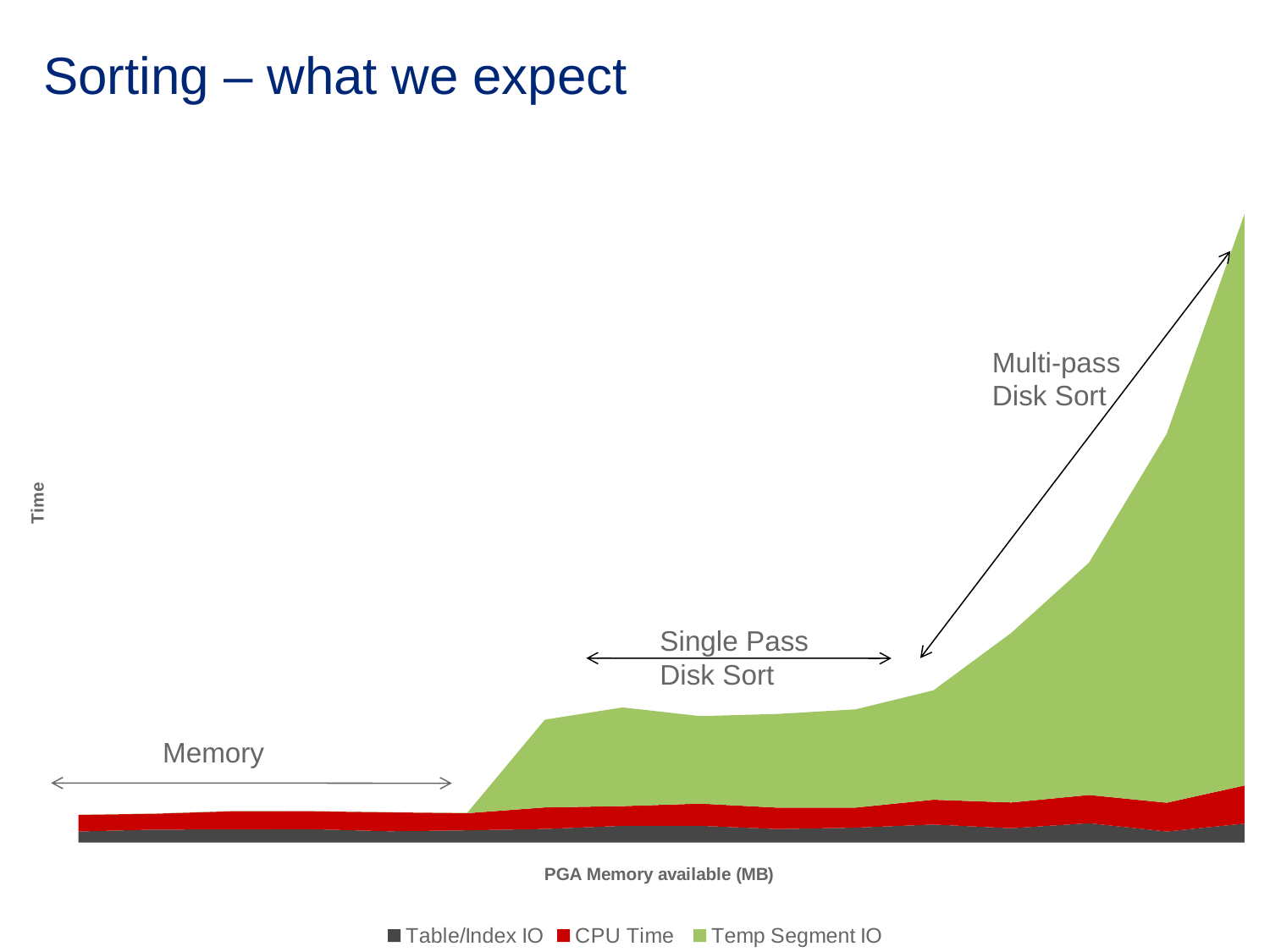
What is the label of the vertical axis? Time What is the label of the horizontal axis? PGA Memory available (MB) Which series is shown in green? Temp Segment IO At the right-hand end of the chart, is the Temp Segment IO area larger or smaller than the CPU Time area? Larger Which series contributes the most to the total time at the right-hand end of the chart? Temp Segment IO How many labelled regions (sort modes) are annotated along the x axis of the chart? 3 How many series does the legend list? 3 Does the total time rise or fall as you move from left to right along the x axis? Rise What kind of chart is shown on the slide? Stacked area chart Which series contributes the least to the total time across the chart? Table/Index IO